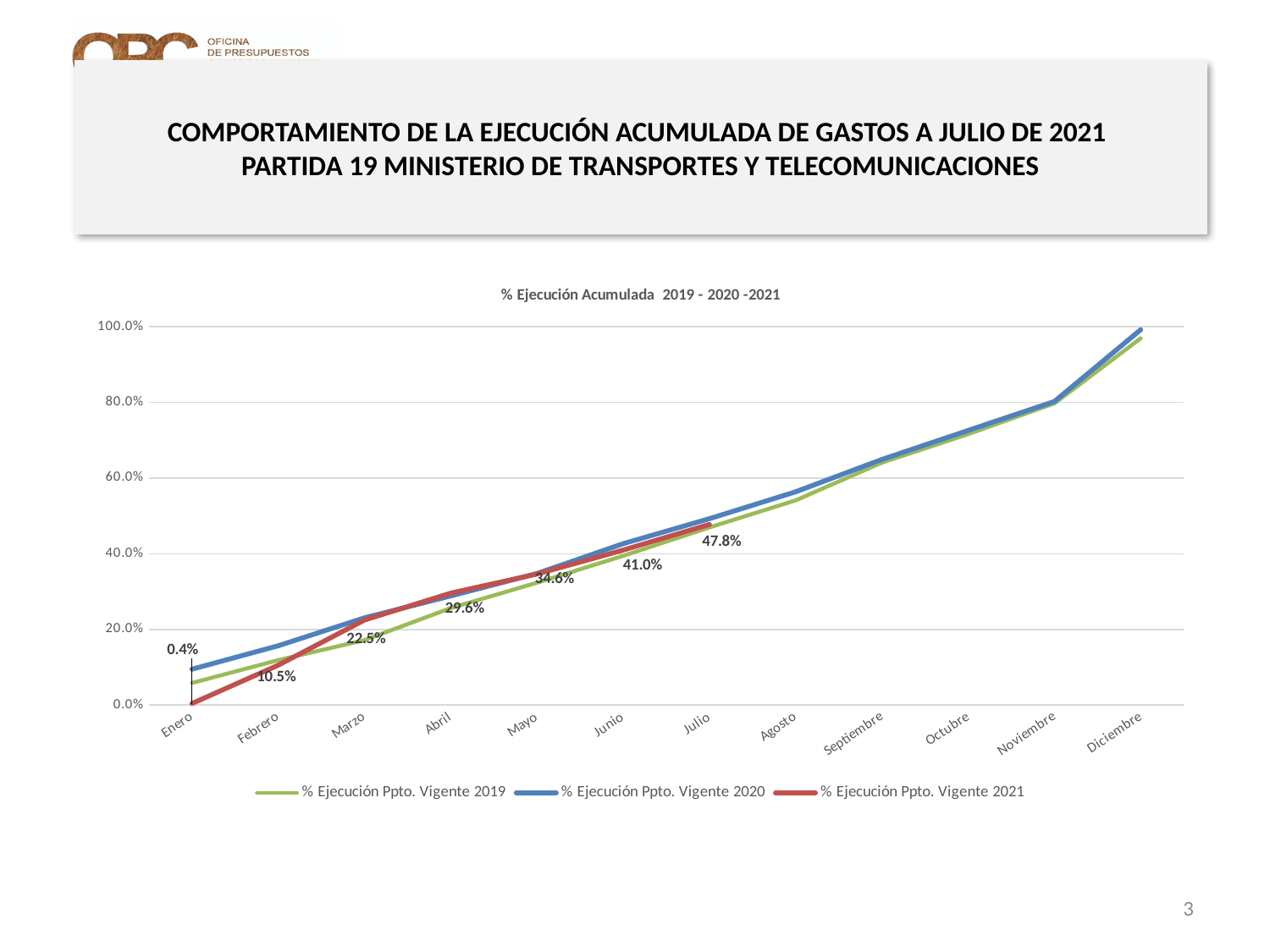
Is the value for % Ejecución Ppto. Vigente 2020 in Diciembre greater or less than 80.0%? greater What is the difference between the 2021 values for Marzo and Febrero? 12.0% What is the value for % Ejecución Ppto. Vigente 2021 in Abril? 29.6% What is the value for % Ejecución Ppto. Vigente 2021 in Enero? 0.4% What is the value for % Ejecución Ppto. Vigente 2021 in Julio? 47.8% What is the difference between the 2021 values for Julio and Junio? 6.8% How many series does the legend list? 3 What type of chart is shown on the slide? line chart What is the title of the chart? % Ejecución Acumulada 2019 - 2020 -2021 Does the % Ejecución Ppto. Vigente 2021 series rise or fall from Enero to Julio? rise How many months are shown on the x axis? 12 In Enero, which series has the larger value: % Ejecución Ppto. Vigente 2020 or % Ejecución Ppto. Vigente 2021? % Ejecución Ppto. Vigente 2020